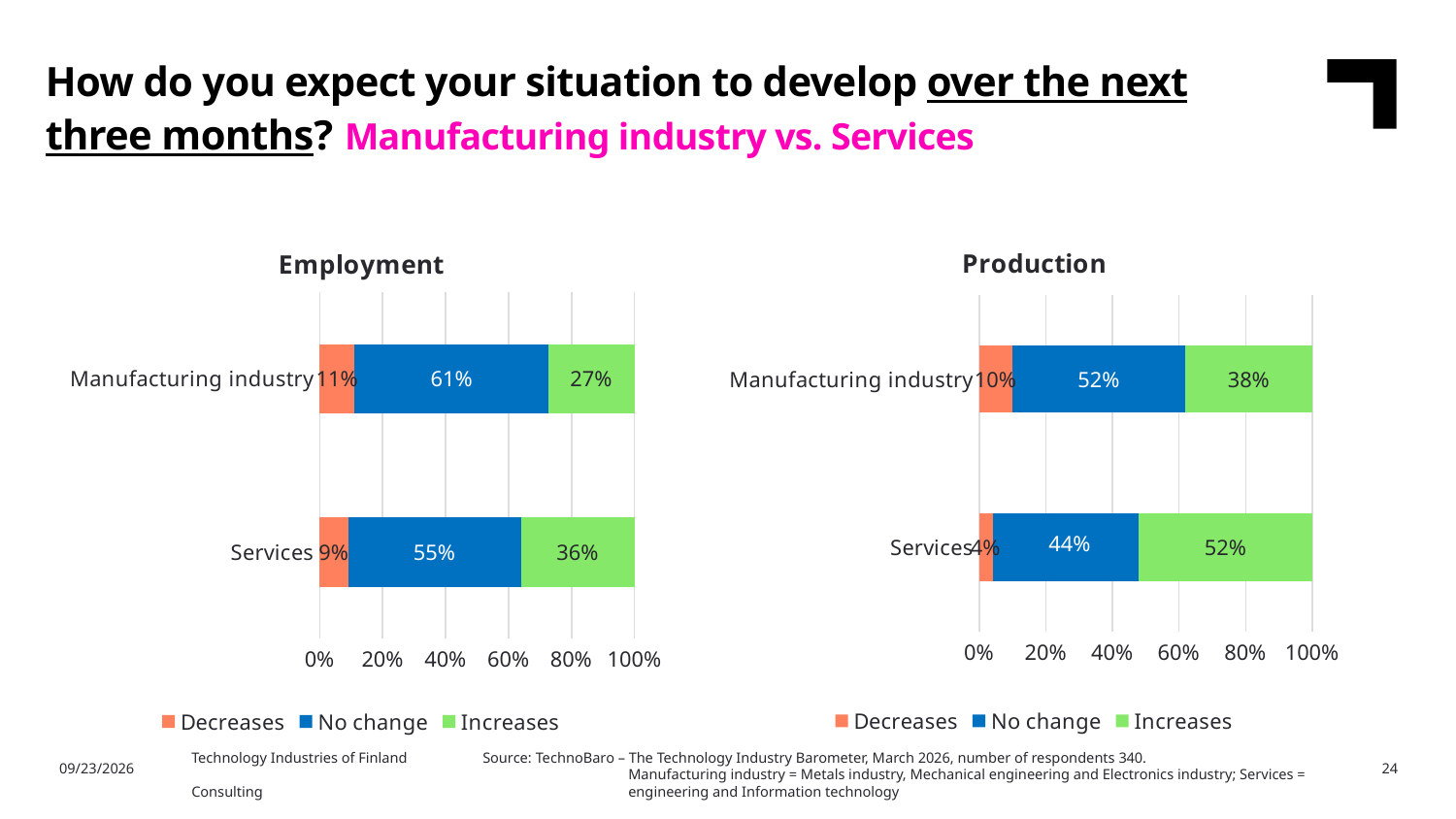
In the Production chart, what is the difference between the Increases share for Services and for Manufacturing industry? 14% What kind of chart is the Production chart? Stacked bar chart In the Employment chart, which category has the higher share of respondents expecting increases, Manufacturing industry or Services? Services In the Production chart, which category has the lower share of respondents expecting decreases? Services In the Employment chart, what percentage of Services respondents expect decreases? 9% In the Production chart, what percentage of Services respondents expect increases? 52% How many categories are shown in the Production chart? 2 In the Employment chart, which colour represents the Increases series? Green In the Production chart, what percentage of Manufacturing industry respondents expect increases? 38% In the Employment chart, what is the difference between the No change share for Manufacturing industry and for Services? 6% How many series does the legend of the Employment chart list? 3 In the Employment chart, what percentage of Manufacturing industry respondents expect no change? 61%